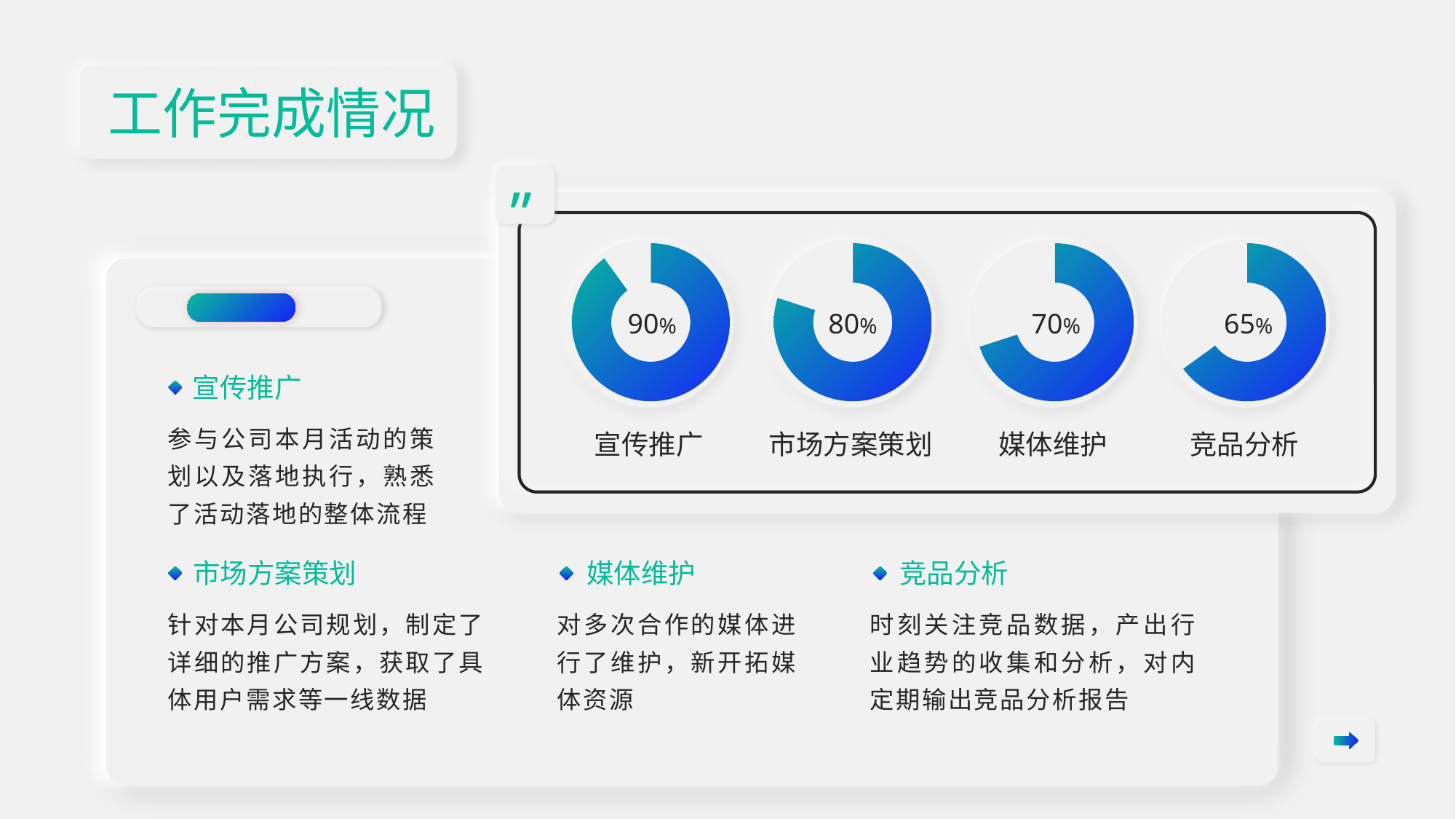
What is the title of the slide containing the donut charts? 工作完成情况 What is the difference between the values for 市场方案策划 and 媒体维护? 10% What is the difference between the values for 宣传推广 and 竞品分析? 25% What is the completion value shown in the donut chart for 市场方案策划? 80% What is the completion value shown in the donut chart for 竞品分析? 65% Which of the four donut charts shows the lowest completion value? 竞品分析 Which of the four donut charts shows the highest completion value? 宣传推广 How many donut charts are shown on the slide? 4 What is the completion value shown in the donut chart for 媒体维护? 70% What kind of chart is used to show each completion value? Donut chart Which has a larger value, 媒体维护 or 竞品分析? 媒体维护 What is the completion value shown in the donut chart for 宣传推广? 90%